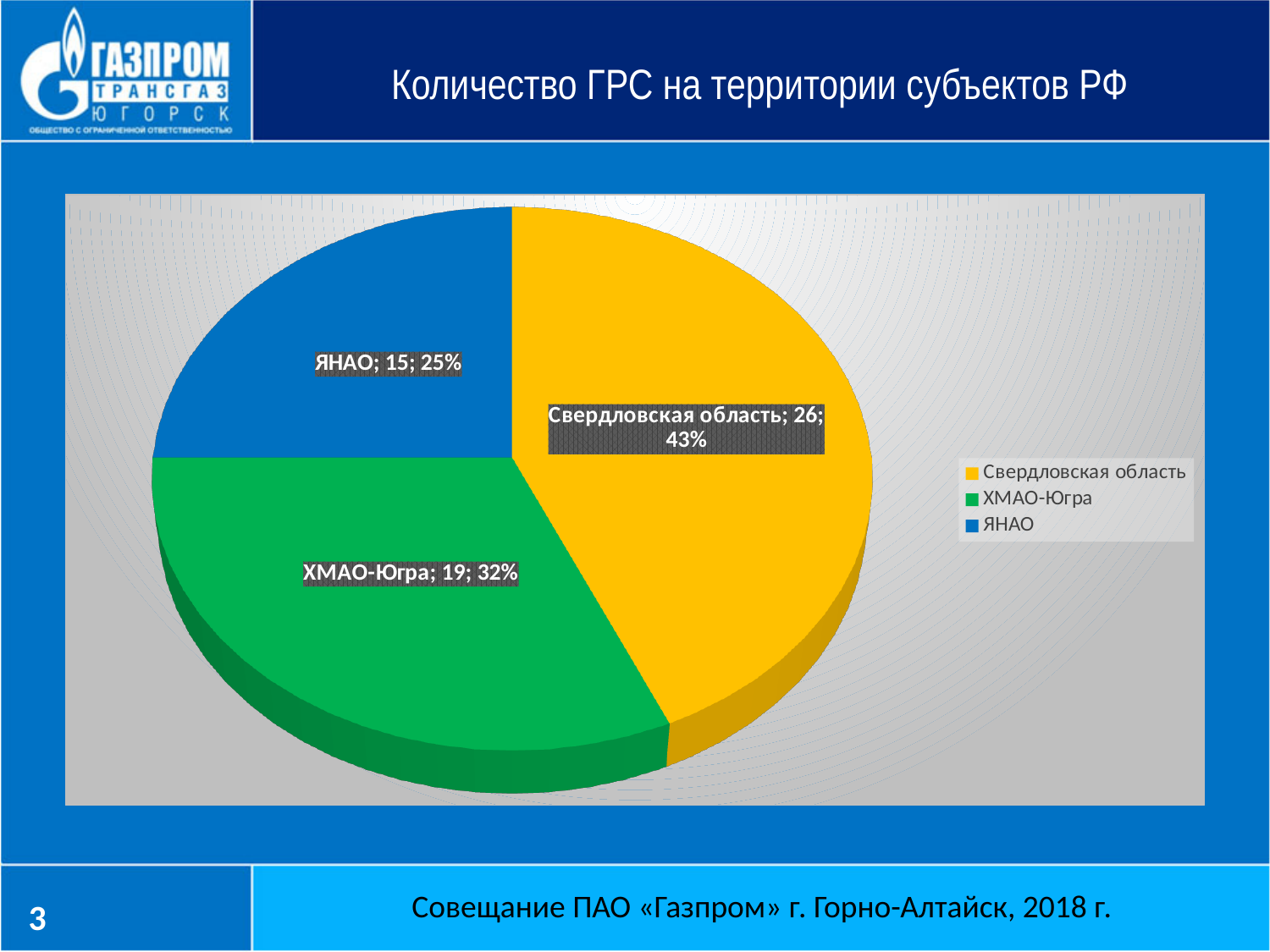
What is the total of all three slices? 60 Which category has the smallest slice? ЯНАО How many slices does the pie chart have? 3 Which is larger, the value for ХМАО-Югра or the value for ЯНАО? ХМАО-Югра What type of chart is shown on the slide? pie chart What is the value for ХМАО-Югра? 19 Which category has the largest slice? Свердловская область What is the value for ЯНАО? 15 What is the difference between the values for Свердловская область and ХМАО-Югра? 7 What share of the pie does ЯНАО represent? 25% What is the value for Свердловская область? 26 What share of the pie does Свердловская область represent? 43%